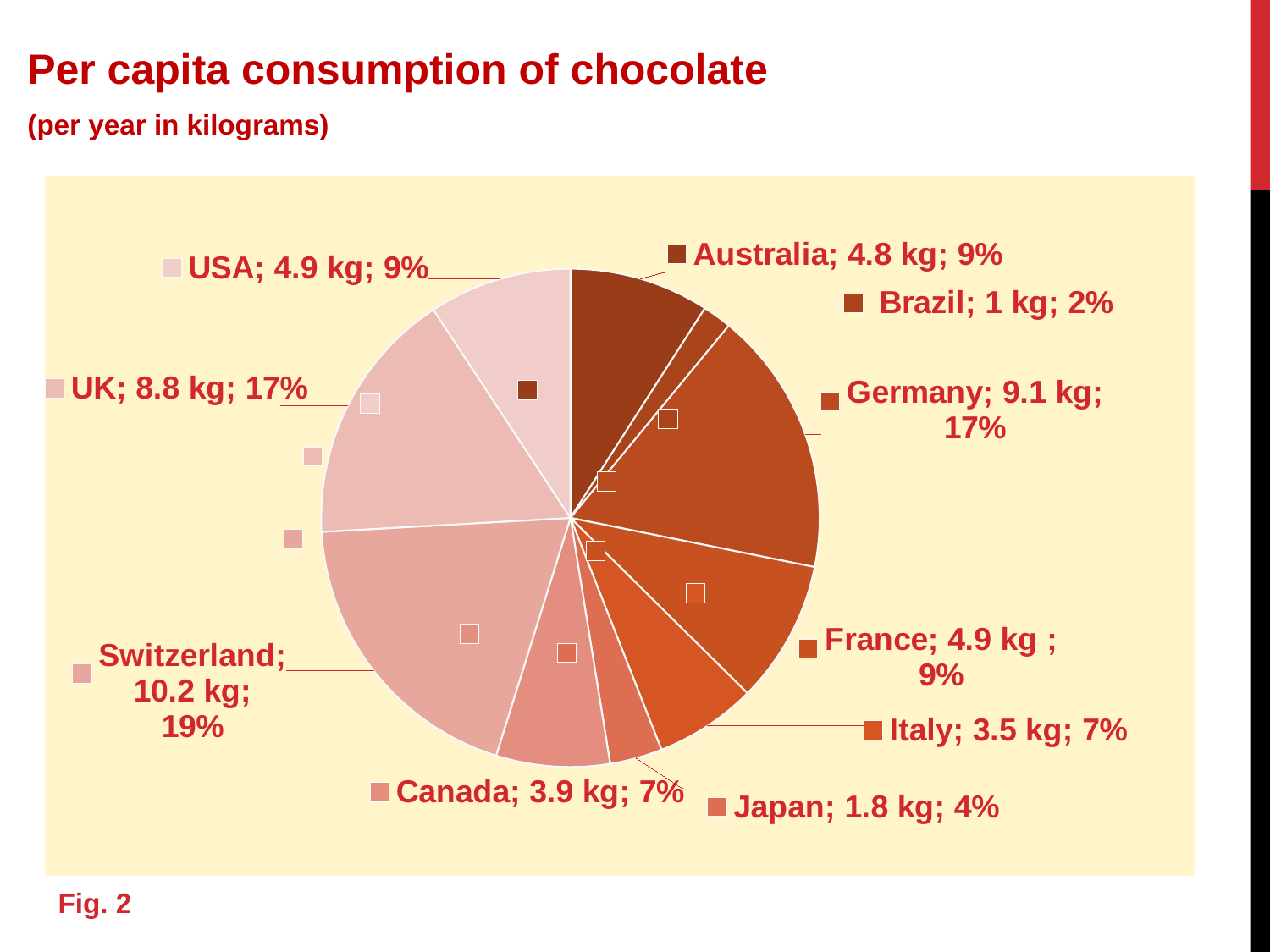
How many countries are shown in the pie chart? 10 What is the per capita chocolate consumption for Germany? 9.1 kg Which country has the highest per capita chocolate consumption? Switzerland Which has a higher per capita chocolate consumption, Italy or Canada? Canada What share of the pie does Switzerland represent? 19% What is the per capita chocolate consumption for Switzerland? 10.2 kg What is the title of the chart? Per capita consumption of chocolate What share of the pie does Japan represent? 4% Which country has the lowest per capita chocolate consumption? Brazil What is the difference in per capita chocolate consumption between Switzerland and the UK? 1.4 kg What is the per capita chocolate consumption for Brazil? 1 kg What kind of chart is shown on the slide? Pie chart